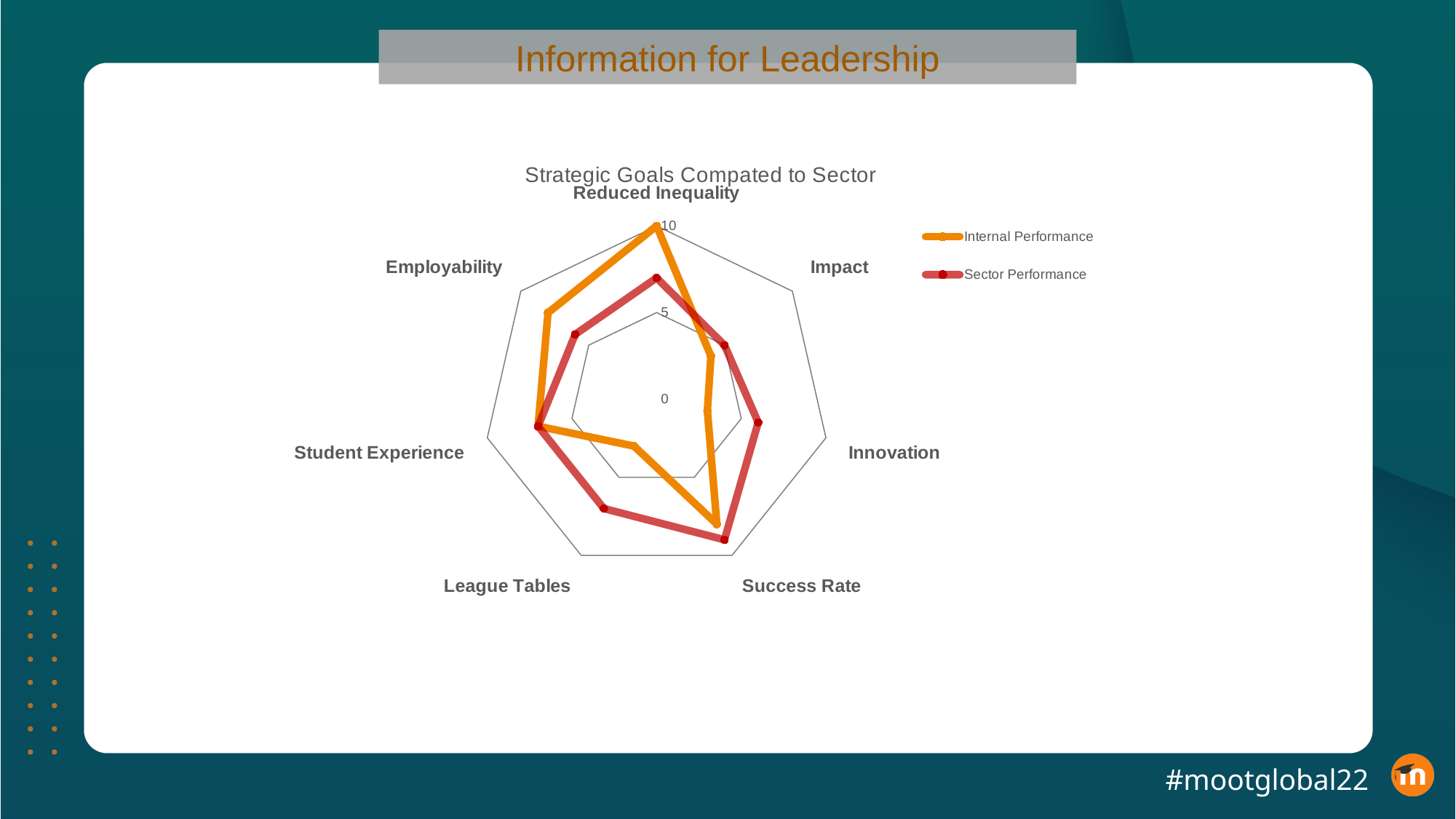
How many series does the legend list? 2 What is the Internal Performance value for Reduced Inequality? 10 Is the Sector Performance value for Innovation greater or less than 5? greater Which is larger for League Tables, Internal Performance or Sector Performance? Sector Performance For which category is Internal Performance highest? Reduced Inequality Which series is drawn in orange? Internal Performance What kind of chart is shown on the slide? Radar chart How many categories (axes) does the radar chart have? 7 Which is larger for Reduced Inequality, Internal Performance or Sector Performance? Internal Performance Is the Internal Performance value for Innovation greater or less than 5? less For which category is Sector Performance highest? Success Rate What is the title of the chart? Strategic Goals Compated to Sector